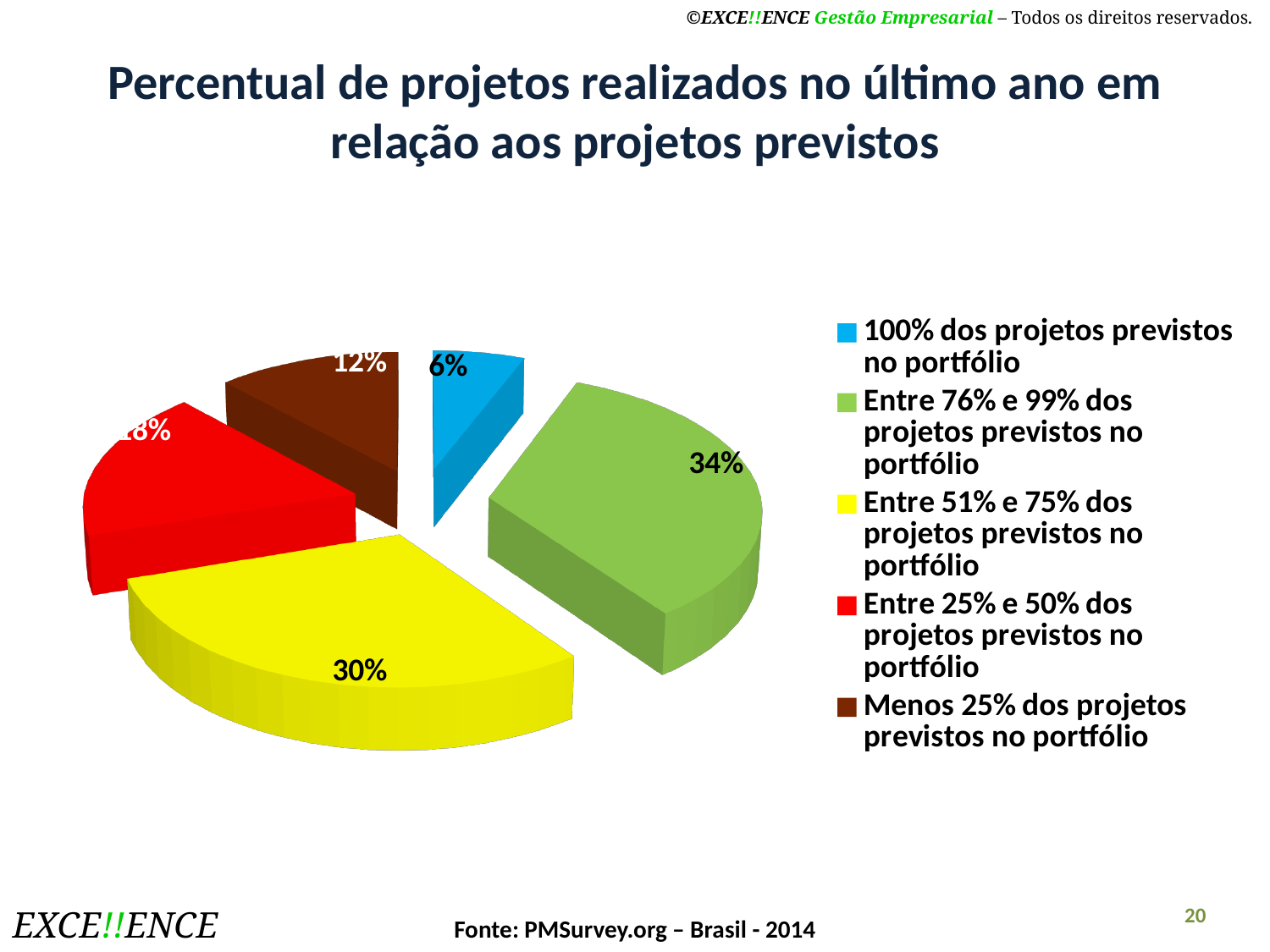
How many categories does the pie chart show? 5 What percentage corresponds to 'Menos 25% dos projetos previstos no portfólio'? 12% What is the difference in percentage points between the 'Entre 76% e 99%' slice and the 'Entre 51% e 75%' slice? 4 percentage points What kind of chart is shown on the slide? Pie chart Which is larger: the slice for 'Entre 51% e 75%' or the slice for 'Menos 25%'? Entre 51% e 75% Which category has the largest slice of the pie? Entre 76% e 99% dos projetos previstos no portfólio What percentage of respondents reported completing between 76% and 99% of the projects planned in the portfolio? 34% What colour is the slice labelled 34%? Green What percentage corresponds to 'Entre 51% e 75% dos projetos previstos no portfólio'? 30% Which category has the smallest slice of the pie? 100% dos projetos previstos no portfólio What source is cited for the chart data? PMSurvey.org – Brasil - 2014 What percentage corresponds to '100% dos projetos previstos no portfólio'? 6%